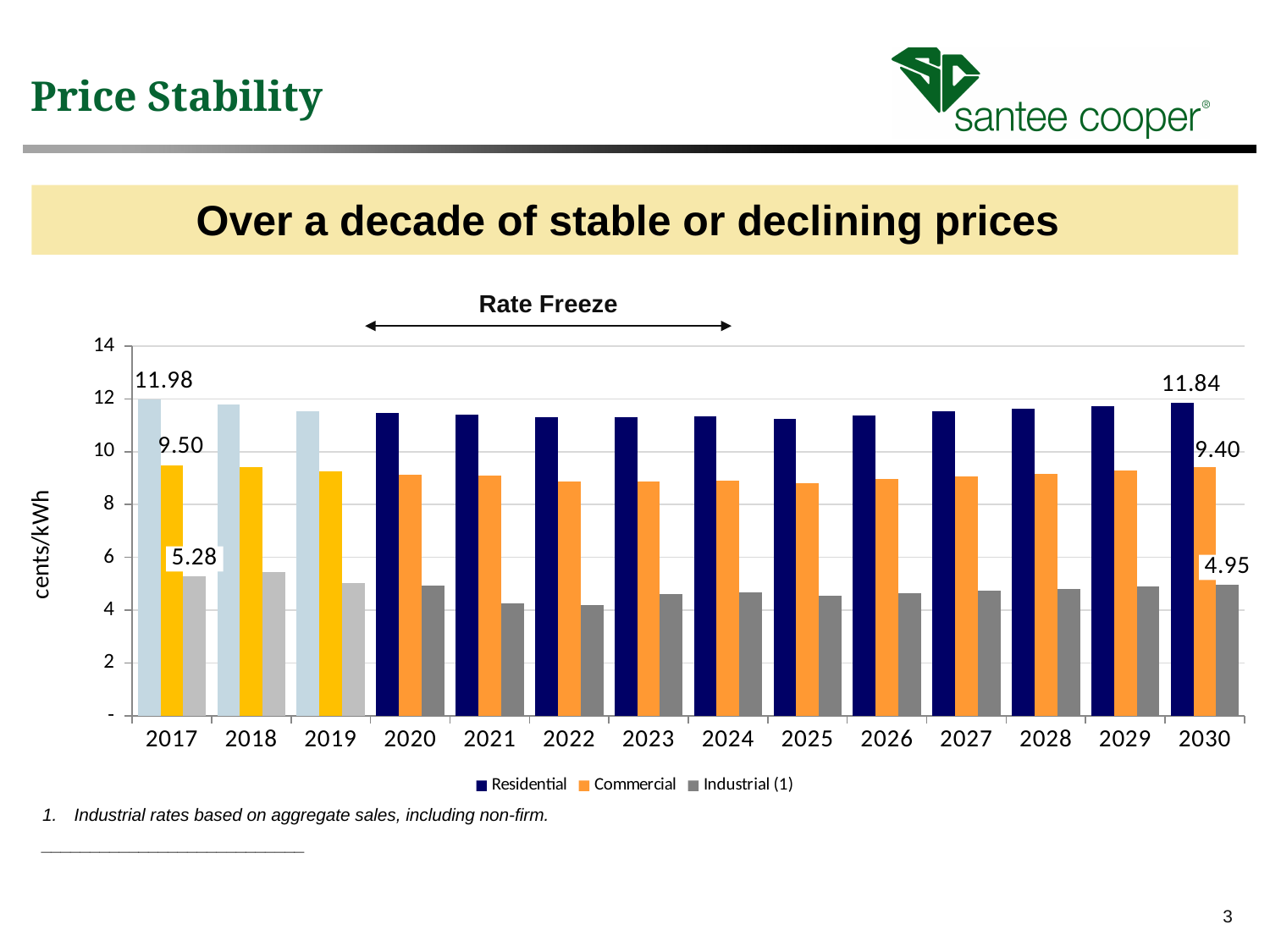
Which series has the highest value in 2017? Residential Which is larger, the Commercial value in 2017 or in 2030? 2017 What is the Industrial (1) value for 2030? 4.95 What is the difference between the Residential value in 2017 and in 2030? 0.14 What is the label on the y axis? cents/kWh Is the Industrial (1) value for 2022 greater or less than 6? less What is the Residential value for 2017? 11.98 How many years are shown on the x axis? 14 What is the Industrial (1) value for 2017? 5.28 How many series does the legend list? 3 What is the Commercial value for 2030? 9.40 What is the difference between the Industrial (1) value in 2017 and in 2030? 0.33